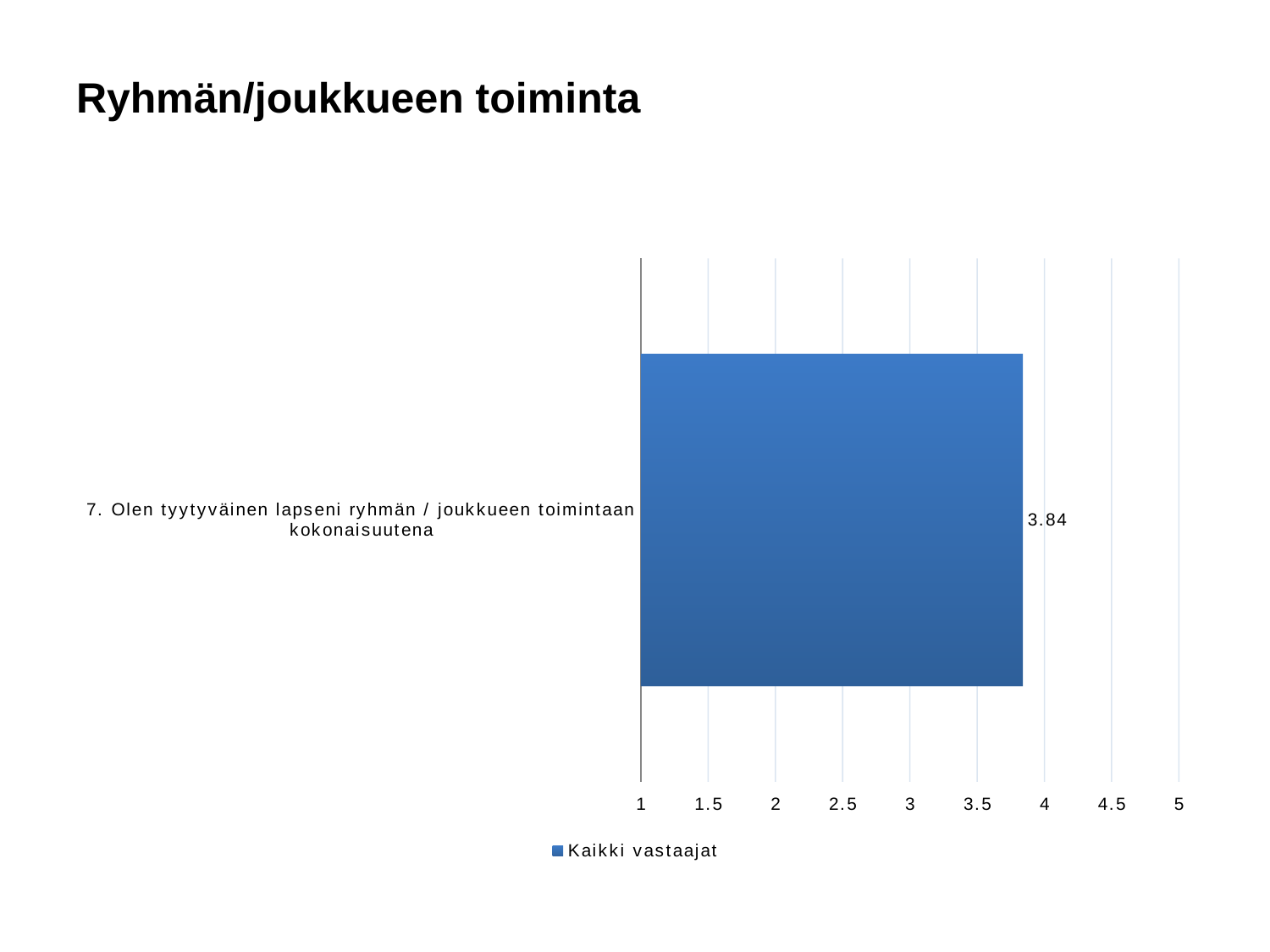
What is the title of the slide above the chart? Ryhmän/joukkueen toiminta How many series does the legend list? 1 What is the maximum value shown on the x axis? 5 Is the value for "7. Olen tyytyväinen lapseni ryhmän / joukkueen toimintaan kokonaisuutena" greater or less than 3.5? greater Is the value for "7. Olen tyytyväinen lapseni ryhmän / joukkueen toimintaan kokonaisuutena" greater or less than 4? less What is the minimum value shown on the x axis? 1 What kind of chart is shown on the slide? bar chart What is the value for "7. Olen tyytyväinen lapseni ryhmän / joukkueen toimintaan kokonaisuutena"? 3.84 How many categories are plotted in the chart? 1 What is the name of the series shown in the legend? Kaikki vastaajat